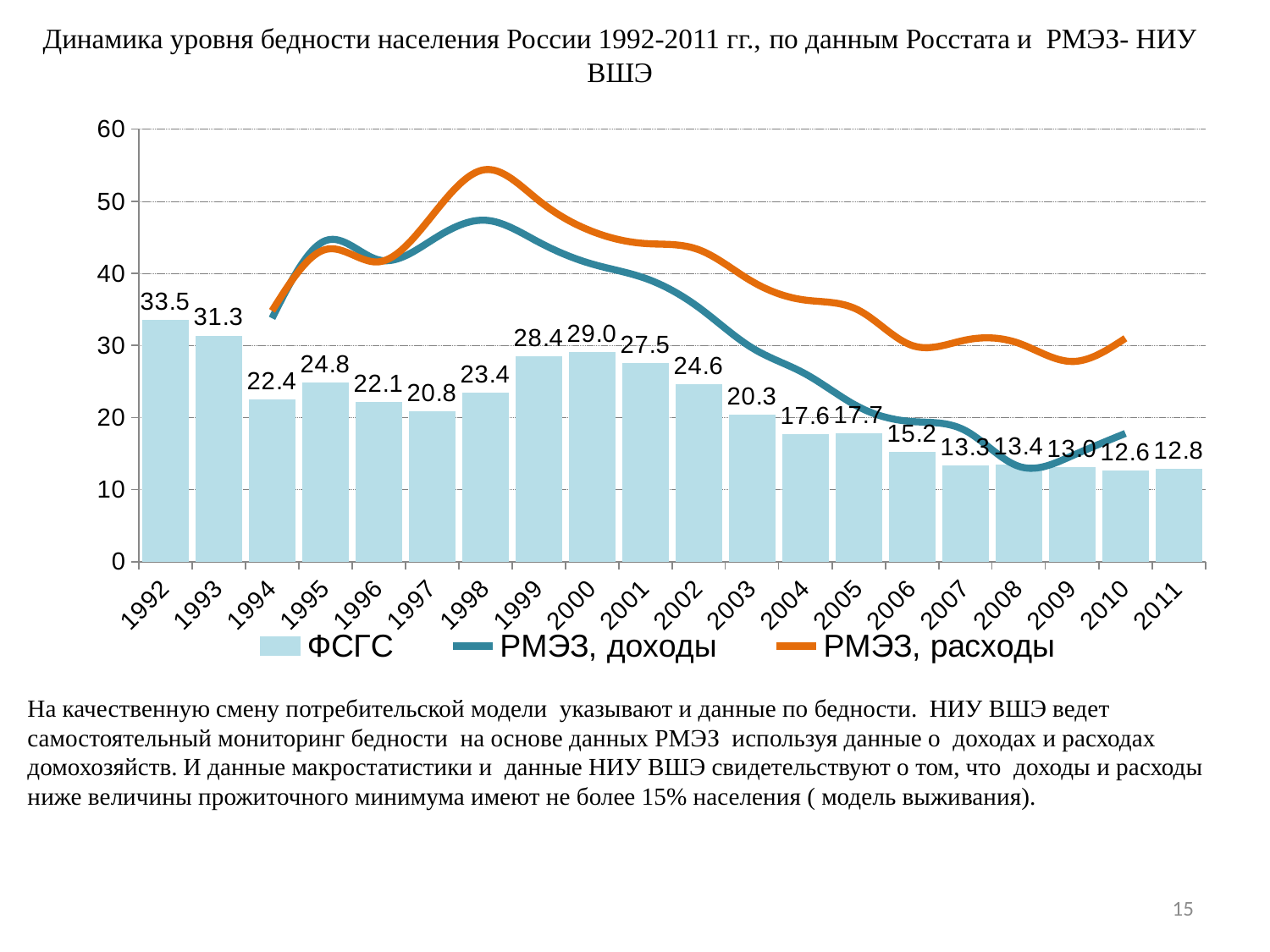
What is the ФСГС value for 1992? 33.5 How many series does the legend list? 3 What is the ФСГС value for 2000? 29.0 How many years are shown on the x axis? 20 Which year has the lowest ФСГС value? 2010 What is the difference between the ФСГС values for 1992 and 2011? 20.7 Is the РМЭЗ, расходы value for 1998 greater or less than 50? greater Is the РМЭЗ, доходы value for 2008 greater or less than 20? less Which year has the highest ФСГС value? 1992 Which is larger, the ФСГС value for 1999 or for 2002? 1999 What kind of chart is this? Combined bar and line chart What is the ФСГС value for 2011? 12.8